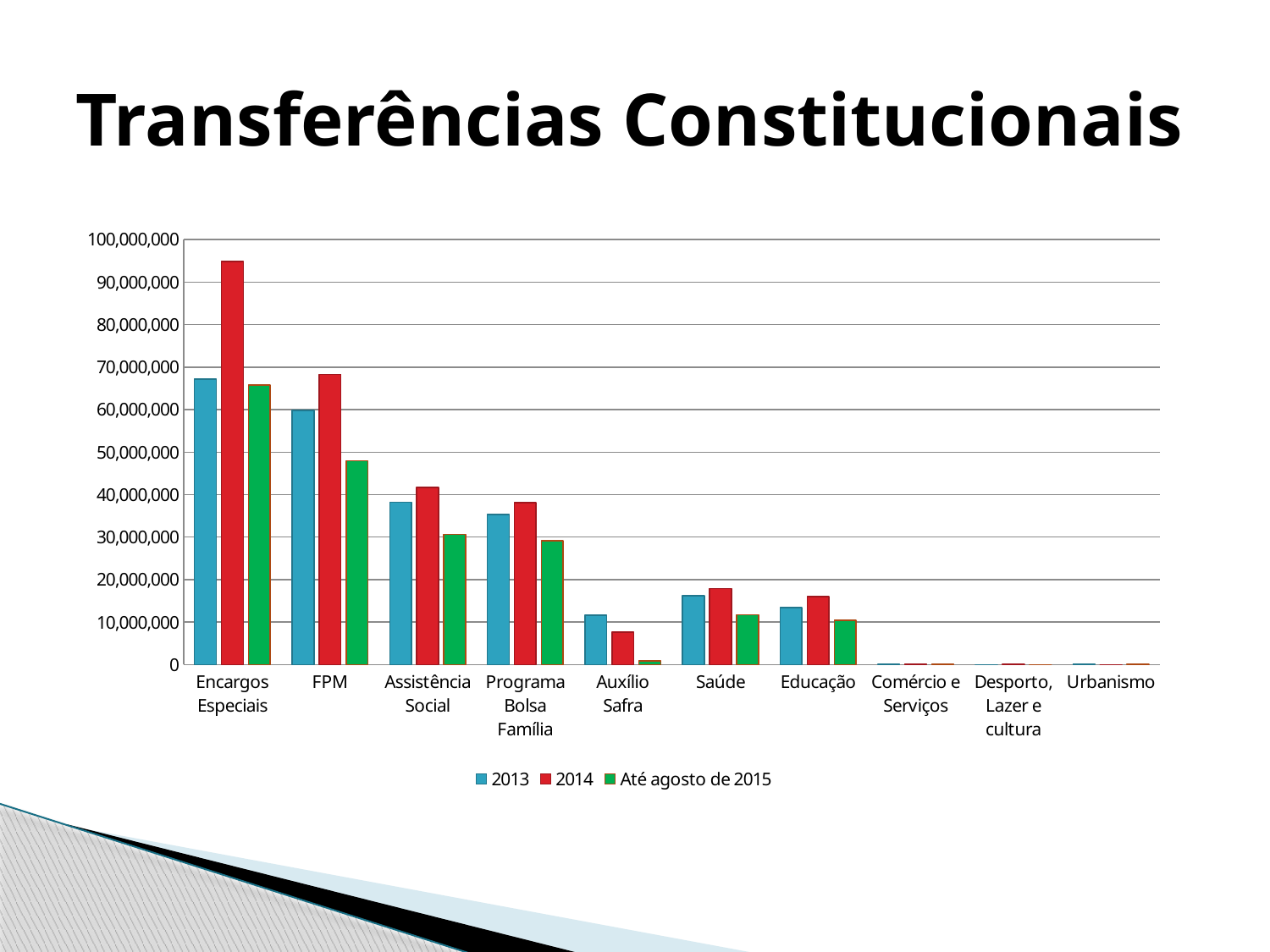
For the 2014 series, which is larger: Saúde or Educação? Saúde Is the 2014 value for Encargos Especiais greater or less than 90,000,000? greater What kind of chart is shown on the slide? bar chart How many series does the legend list? 3 Is the Até agosto de 2015 value for FPM greater or less than 40,000,000? greater Is the 2014 value for Assistência Social greater or less than 40,000,000? greater For Auxílio Safra, which is larger: the 2013 value or the 2014 value? 2013 What are the three series listed in the legend? 2013, 2014, Até agosto de 2015 How many categories are shown on the x axis? 10 Which category has the highest value for the 2014 series? Encargos Especiais What is the title of the slide? Transferências Constitucionais